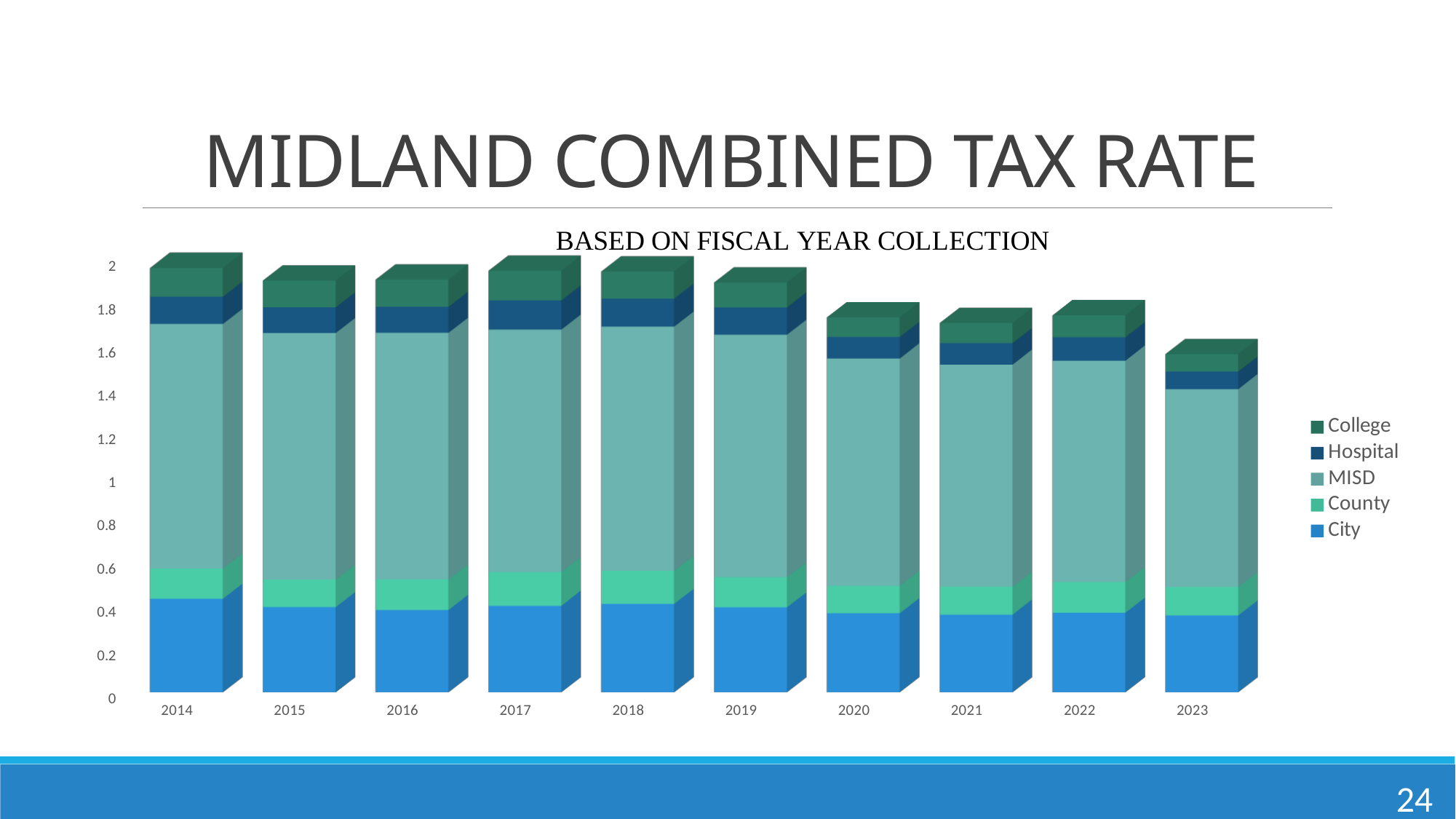
Is the total combined tax rate for 2023 greater or less than 1.8? less What kind of chart is shown on the slide? Stacked bar chart How many years are shown on the x axis of the chart? 10 Is the total combined tax rate for 2014 greater or less than 1.8? greater Do the total combined tax rates generally rise or fall from 2014 to 2023? fall What is the title printed above the chart's plot area? BASED ON FISCAL YEAR COLLECTION Is the total combined tax rate for 2023 greater or less than 1.4? greater How many series does the chart's legend list? 5 Which series is listed first in the chart's legend? College Which year has the larger total combined tax rate, 2014 or 2023? 2014 Which year has the lowest total combined tax rate? 2023